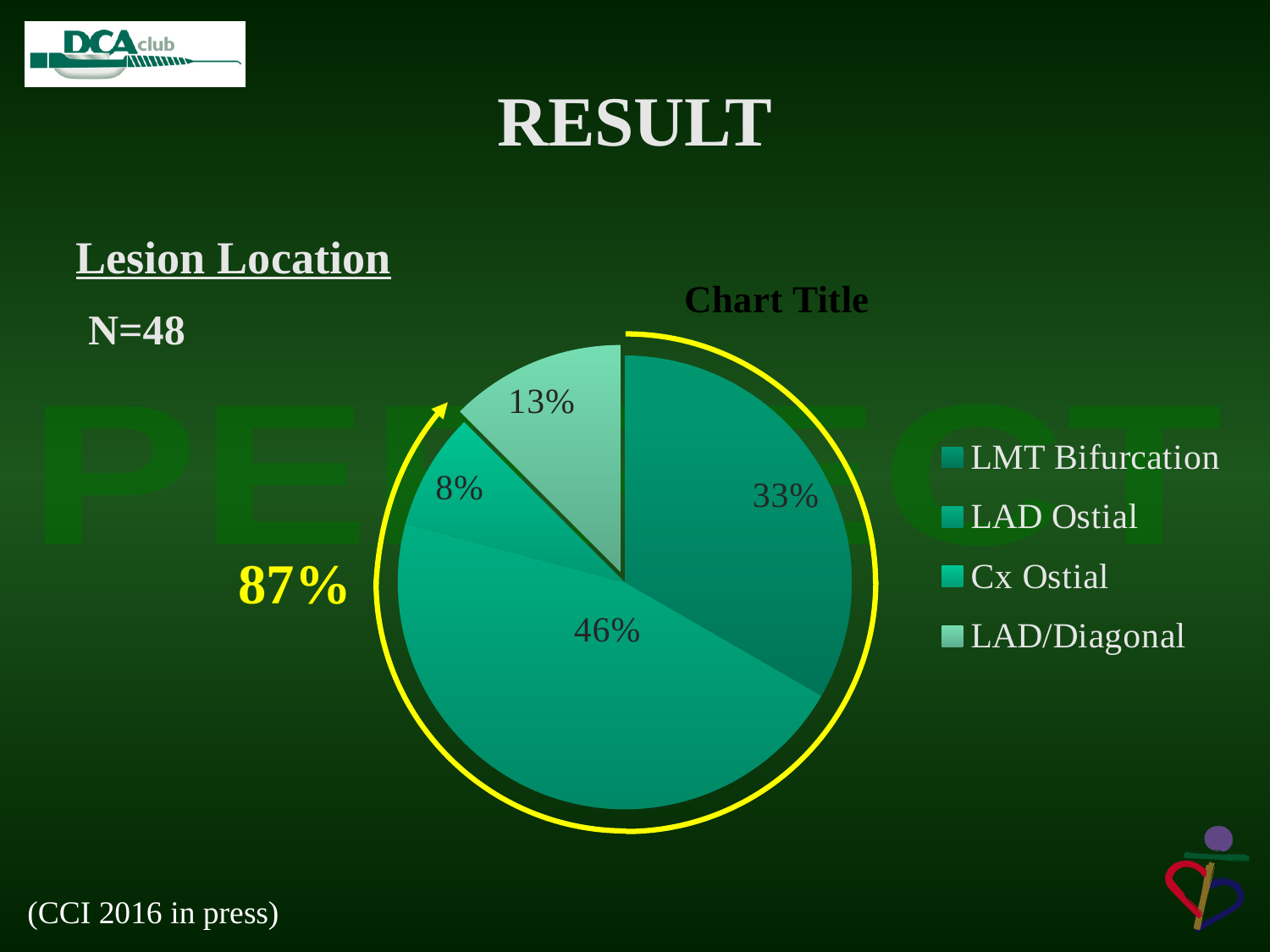
What percentage of the pie chart is LAD/Diagonal? 13% What is the title printed above the pie chart? Chart Title Which lesion location has the largest share of the pie chart? LAD Ostial Which lesion location has the smallest share of the pie chart? Cx Ostial Which has a larger share of the pie chart, LAD/Diagonal or Cx Ostial? LAD/Diagonal What type of chart is shown on the slide? Pie chart What percentage of the pie chart is LAD Ostial? 46% How many slices does the pie chart have? 4 What percentage of the pie chart is Cx Ostial? 8% How many entries does the chart legend list? 4 What is the difference in percentage points between LAD Ostial and LMT Bifurcation? 13 What percentage of the pie chart is LMT Bifurcation? 33%